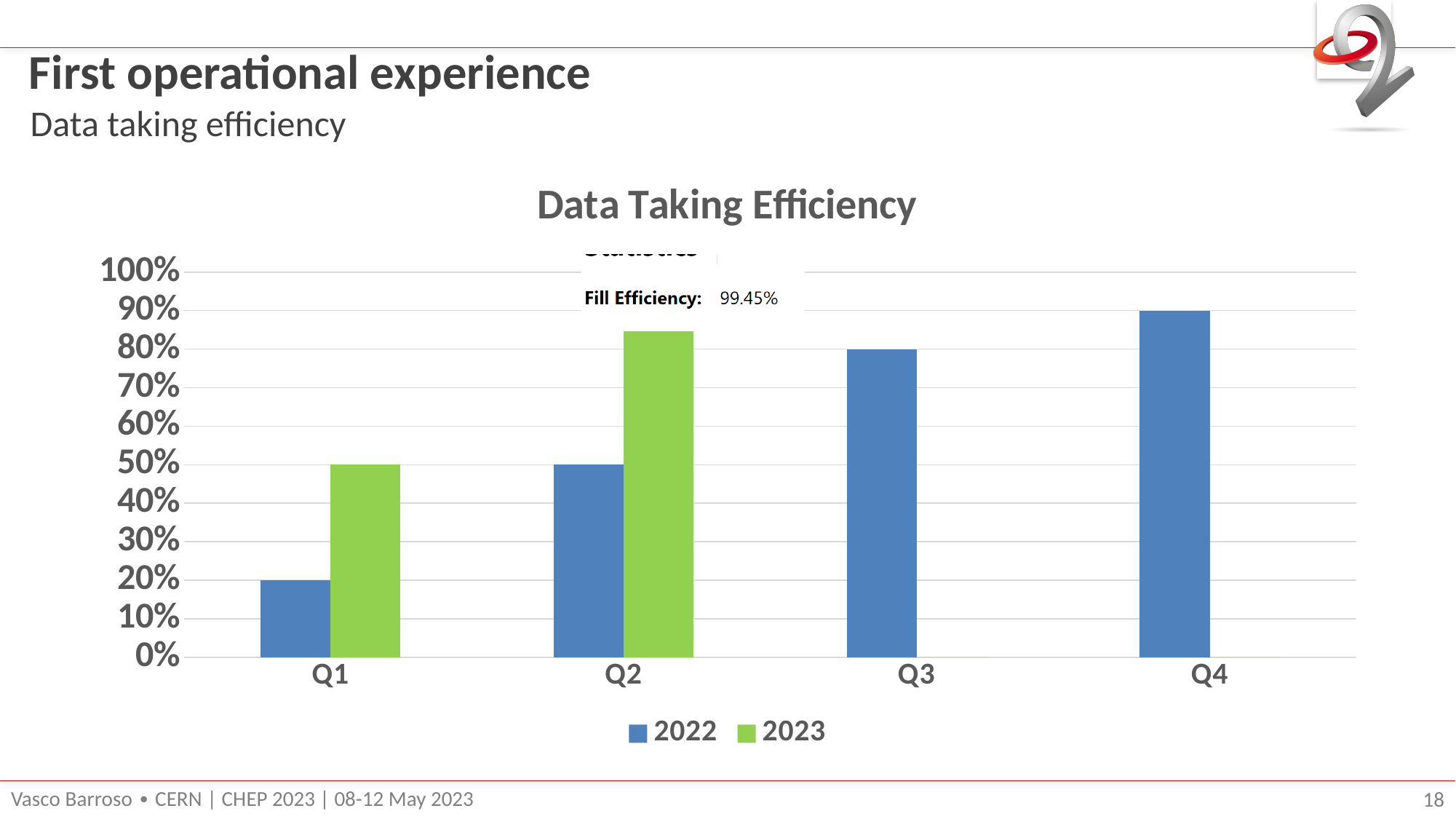
Which quarter has the lowest 2022 efficiency? Q1 How many series does the legend list? 2 Which quarter has the highest 2022 efficiency? Q4 What is the 2022 data taking efficiency for Q1? 20% Do the 2022 efficiency values rise or fall from Q1 to Q4? rise How many quarters are shown on the x axis? 4 Is the 2023 efficiency for Q2 greater or less than 80%? greater What is the title of the chart? Data Taking Efficiency What kind of chart is shown on the slide? bar chart What is the 2022 data taking efficiency for Q4? 90% Which is larger for Q1, the 2022 value or the 2023 value? 2023 What is the 2023 data taking efficiency for Q1? 50%